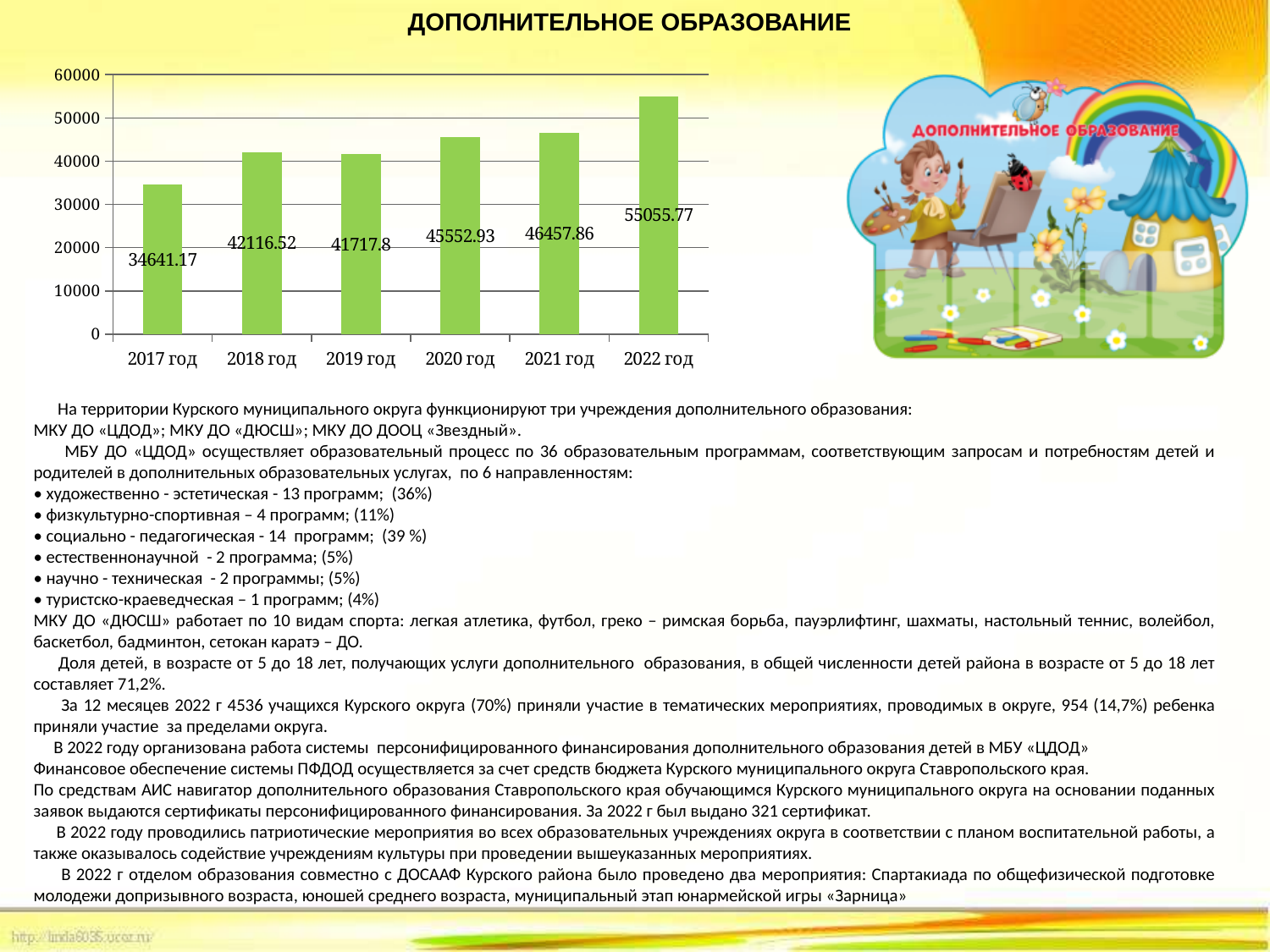
Which is larger, the value for 2018 год or the value for 2019 год? 2018 год What is the difference between the values for 2022 год and 2021 год? 8597.91 What is the value for 2022 год? 55055.77 Is the value for 2021 год greater or less than 50000? less What kind of chart is shown on the slide? bar chart Which year has the lowest value? 2017 год Do the values generally rise or fall from 2017 год to 2022 год? rise How many years are shown on the x axis? 6 What is the difference between the values for 2018 год and 2019 год? 398.72 What is the value for 2020 год? 45552.93 Which year has the highest value? 2022 год What is the value for 2017 год? 34641.17